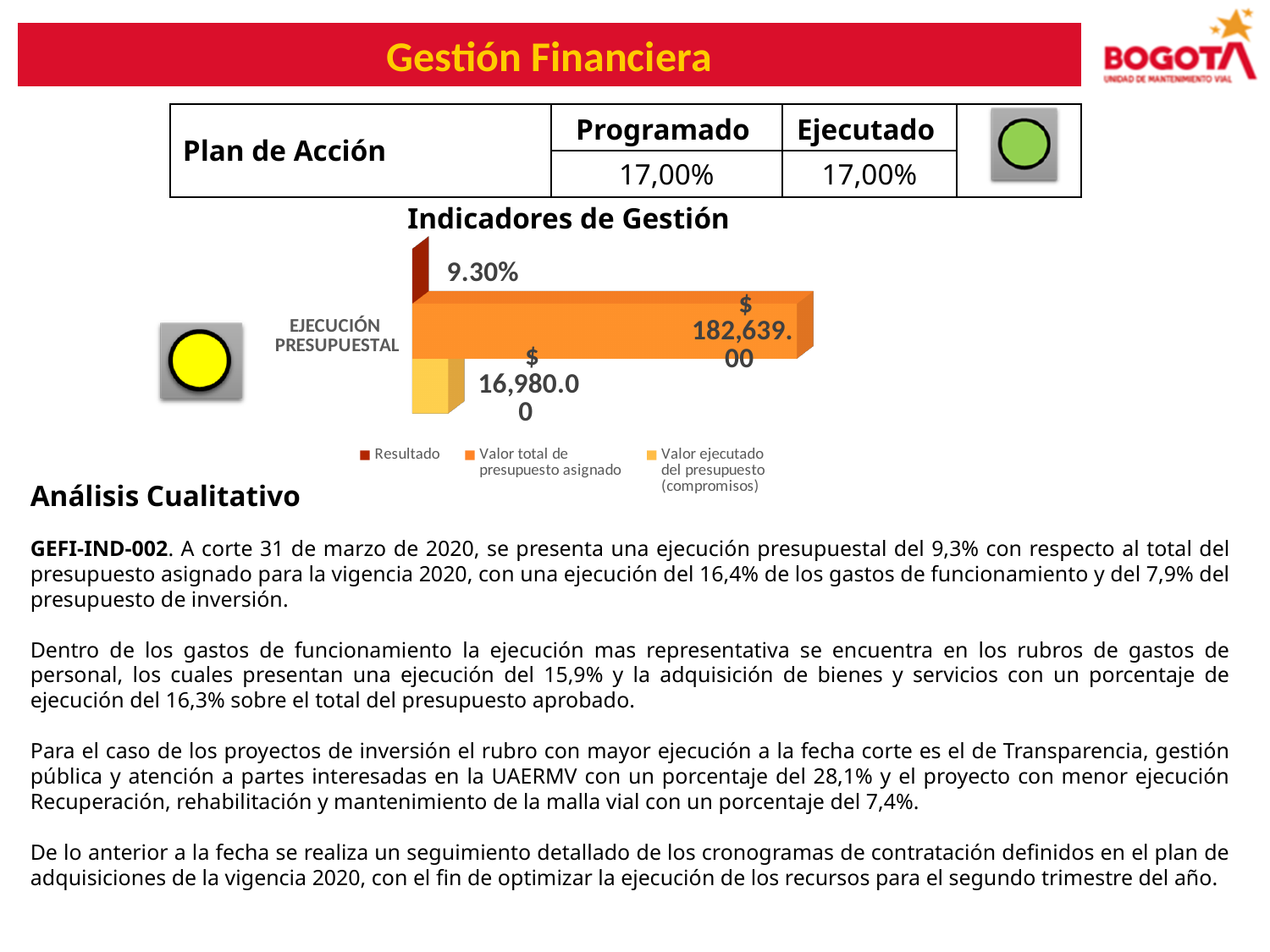
What is the value of the "Resultado" series for EJECUCIÓN PRESUPUESTAL in the "Indicadores de Gestión" chart? 9.30% Which series has the longest bar in the "Indicadores de Gestión" chart? Valor total de presupuesto asignado What is the value of "Valor ejecutado del presupuesto (compromisos)" in the "Indicadores de Gestión" chart? $ 16,980.00 In the "Indicadores de Gestión" chart, which is larger: "Valor total de presupuesto asignado" or "Valor ejecutado del presupuesto (compromisos)"? Valor total de presupuesto asignado How many series does the legend of the "Indicadores de Gestión" chart list? 3 How many categories are plotted on the "Indicadores de Gestión" chart? 1 What is the name of the single category shown on the "Indicadores de Gestión" chart? EJECUCIÓN PRESUPUESTAL What is the value of "Valor total de presupuesto asignado" in the "Indicadores de Gestión" chart? $ 182,639.00 In the "Indicadores de Gestión" chart, what is the difference between "Valor total de presupuesto asignado" and "Valor ejecutado del presupuesto (compromisos)"? $ 165,659.00 What type of chart is shown under the title "Indicadores de Gestión"? bar chart What is the title of the chart on the slide? Indicadores de Gestión